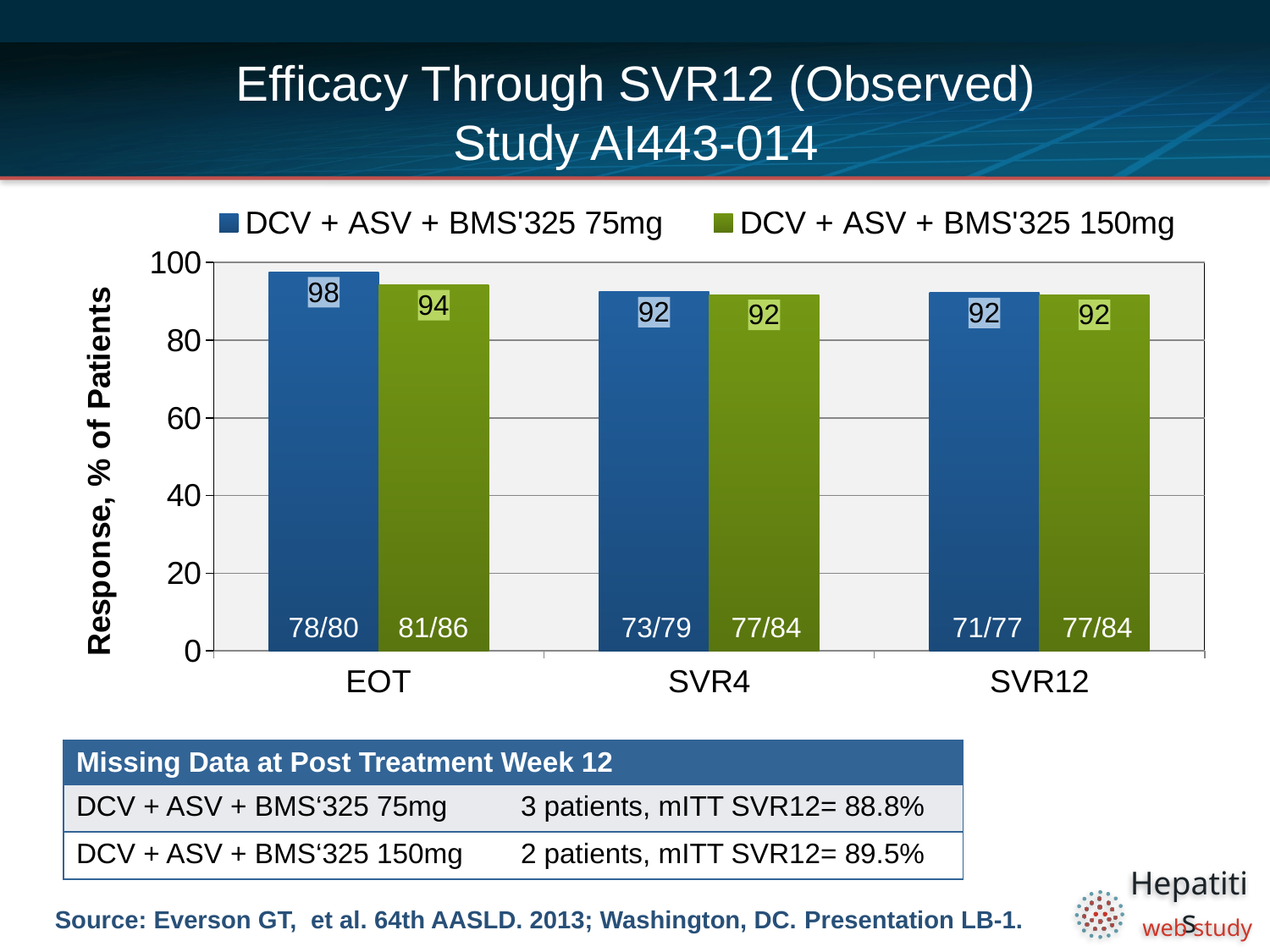
What is the response value for DCV + ASV + BMS'325 150mg at EOT? 94 What kind of chart is shown on the slide? Bar chart What is the label of the y axis? Response, % of Patients What is the response value for DCV + ASV + BMS'325 150mg at SVR4? 92 Is the response value for DCV + ASV + BMS'325 150mg at SVR12 greater or less than 80? greater How many series does the legend list? 2 What is the response value for DCV + ASV + BMS'325 75mg at EOT? 98 Which is larger at EOT: the response for the 75mg arm or the 150mg arm? DCV + ASV + BMS'325 75mg What is the difference between the EOT response values for the 75mg and 150mg arms? 4 How many time point categories are shown on the x axis? 3 What is the response value for DCV + ASV + BMS'325 75mg at SVR12? 92 Which time point has the highest response for DCV + ASV + BMS'325 75mg? EOT